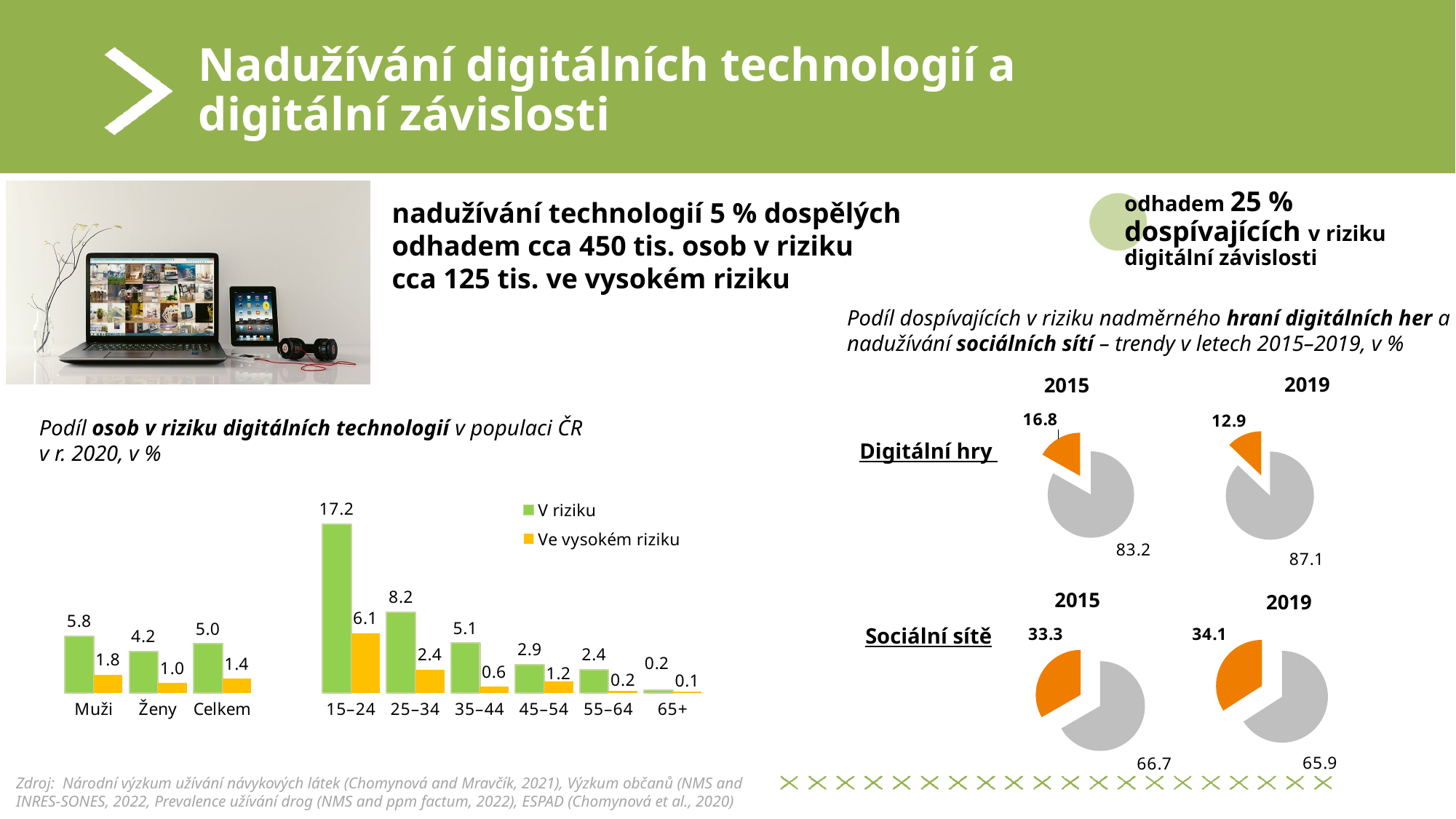
In the bar chart on the left, which is larger: the 'V riziku' value for 25–34 or for 35–44? 25–34 In the bar chart on the left, which age group has the highest 'V riziku' value? 15–24 In the bar chart on the left, what is the 'V riziku' value for the 15–24 age group? 17.2 What type of chart is used for the 'Podíl osob v riziku digitálních technologií' data on the left? bar chart In the 'Sociální sítě' pie chart for 2019, what share is shown for the grey slice? 65.9 In the 'Digitální hry' pie chart for 2015, what share is shown for the orange slice? 16.8 How many series does the legend of the bar chart on the left list? 2 In the bar chart on the left, do the 'V riziku' values rise or fall across the age groups from 15–24 to 65+? fall In the bar chart on the left, what is the 'Ve vysokém riziku' value for Muži? 1.8 In the bar chart on the left, which age group has the lowest 'Ve vysokém riziku' value? 65+ What is the difference between the orange slice values in the 'Digitální hry' pie charts for 2015 and 2019? 3.9 In the bar chart on the left, what is the difference between the 'V riziku' values for Muži and Ženy? 1.6